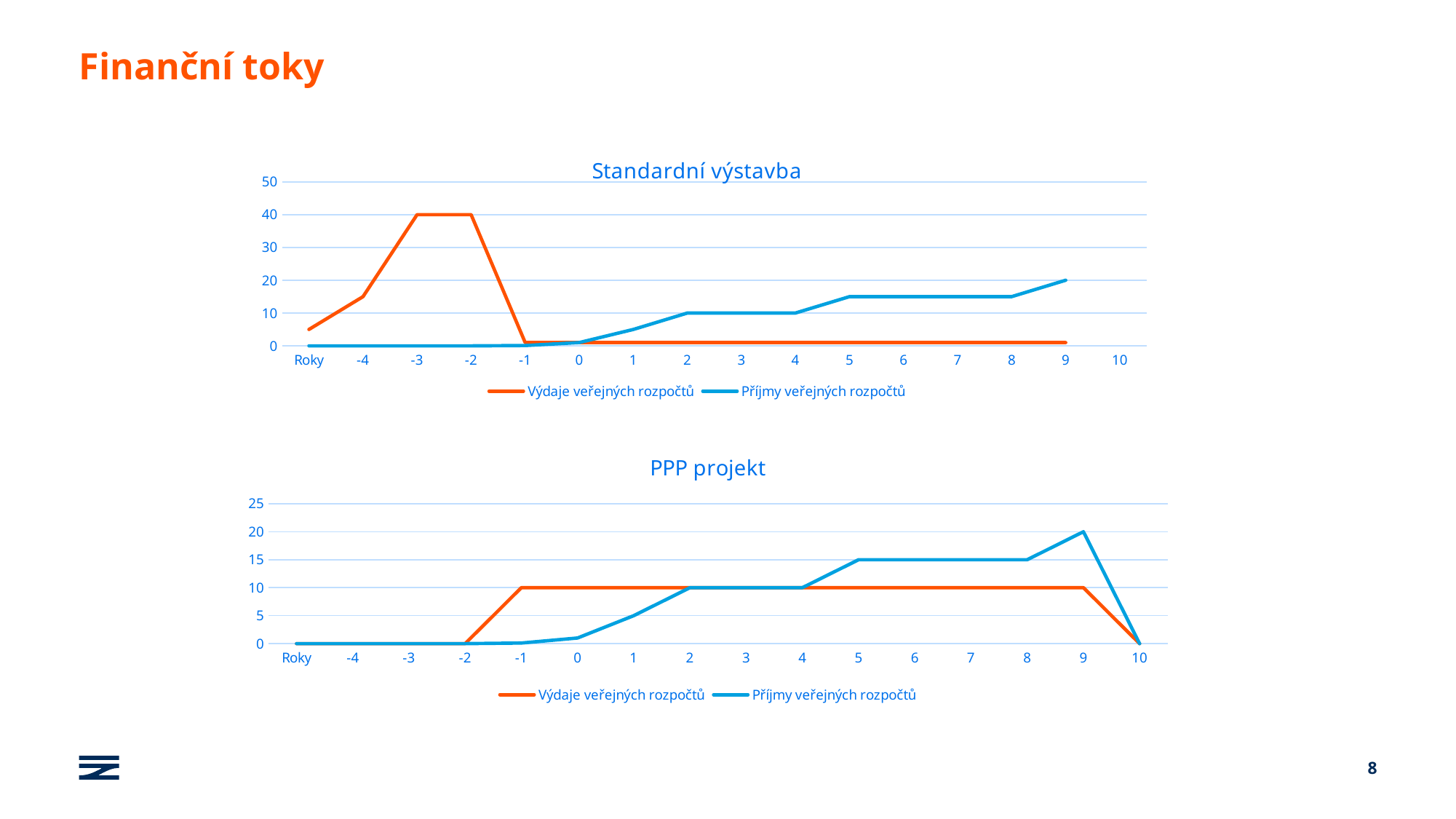
In the "Standardní výstavba" chart, what is the value of Výdaje veřejných rozpočtů at year -3? 40 In the "Standardní výstavba" chart, what is the value of Příjmy veřejných rozpočtů at year 9? 20 What type of chart is the "Standardní výstavba" chart? line chart In the "PPP projekt" chart, what is the difference between Příjmy veřejných rozpočtů and Výdaje veřejných rozpočtů at year 9? 10 In the "PPP projekt" chart, does Příjmy veřejných rozpočtů rise or fall between year 9 and year 10? fall In the "Standardní výstavba" chart, which series is higher at year 5, Výdaje veřejných rozpočtů or Příjmy veřejných rozpočtů? Příjmy veřejných rozpočtů How many series does the legend of the "PPP projekt" chart list? 2 In the "PPP projekt" chart, what is the value of Příjmy veřejných rozpočtů at year 6? 15 In the "PPP projekt" chart, what is the value of Výdaje veřejných rozpočtů at year 3? 10 In the "Standardní výstavba" chart, is the value of Výdaje veřejných rozpočtů at year -4 greater or less than 20? less In the "PPP projekt" chart, what is the value of Příjmy veřejných rozpočtů at year 9? 20 In the "Standardní výstavba" chart, at which year does Výdaje veřejných rozpočtů reach its highest value (first occurrence)? -3